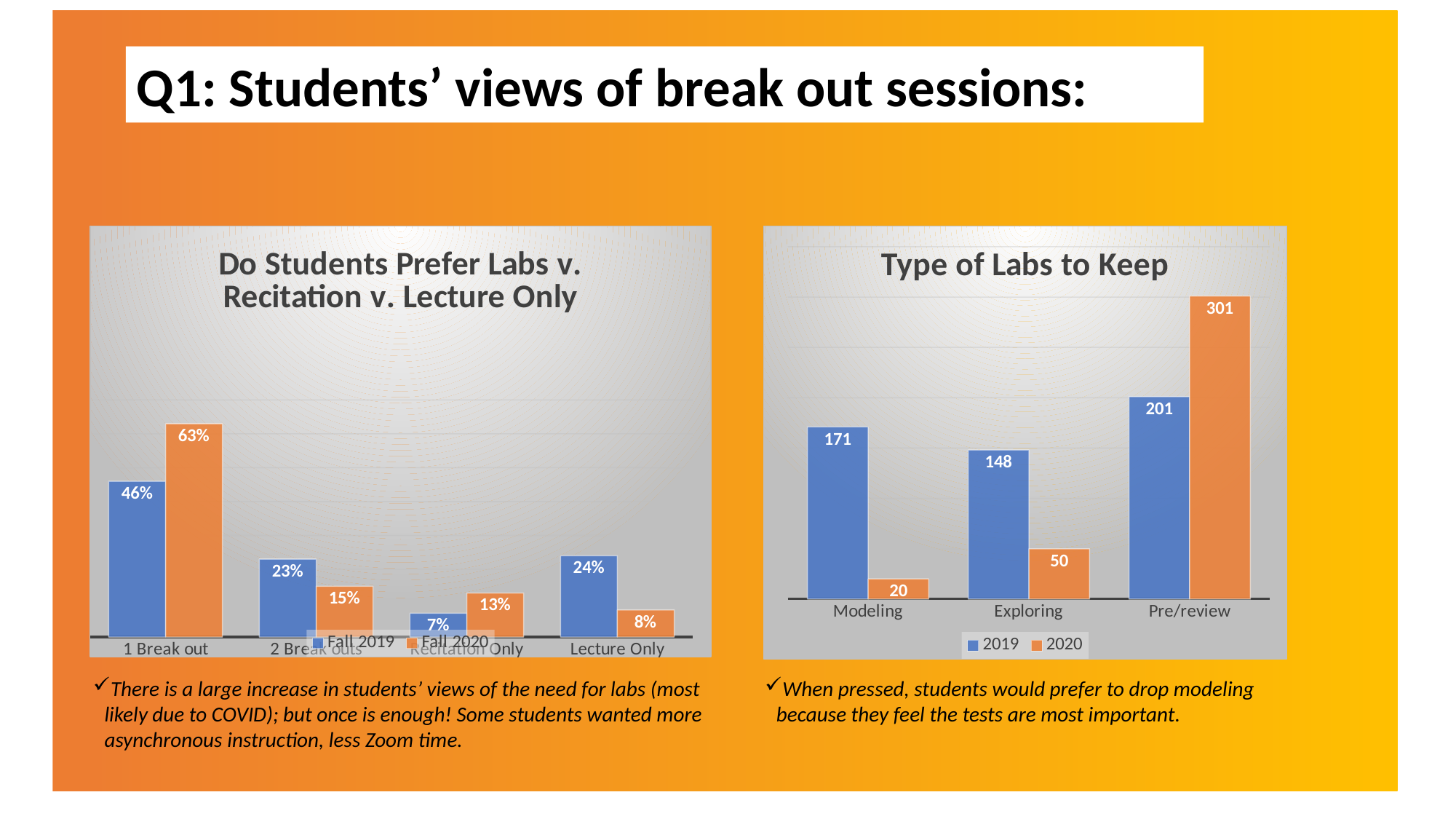
In the 'Do Students Prefer Labs v. Recitation v. Lecture Only' chart, which category has the lowest Fall 2020 value? Lecture Only In the 'Type of Labs to Keep' chart, how many categories are shown on the x axis? 3 In the 'Do Students Prefer Labs v. Recitation v. Lecture Only' chart, which category has the highest Fall 2019 value? 1 Break out In the 'Type of Labs to Keep' chart, what is the difference between the 2019 and 2020 values for Modeling? 151 What kind of chart is 'Type of Labs to Keep'? Bar chart In the 'Type of Labs to Keep' chart, what is the 2019 value for Exploring? 148 In the 'Type of Labs to Keep' chart, which category has the lowest 2020 value? Modeling In the 'Do Students Prefer Labs v. Recitation v. Lecture Only' chart, what is the Fall 2020 value for 1 Break out? 63% In the 'Type of Labs to Keep' chart, what is the 2020 value for Pre/review? 301 In the 'Do Students Prefer Labs v. Recitation v. Lecture Only' chart, what is the Fall 2019 value for Lecture Only? 24% In the 'Do Students Prefer Labs v. Recitation v. Lecture Only' chart, how many series does the legend list? 2 In the 'Do Students Prefer Labs v. Recitation v. Lecture Only' chart, what is the difference between the Fall 2020 and Fall 2019 values for 1 Break out? 17%